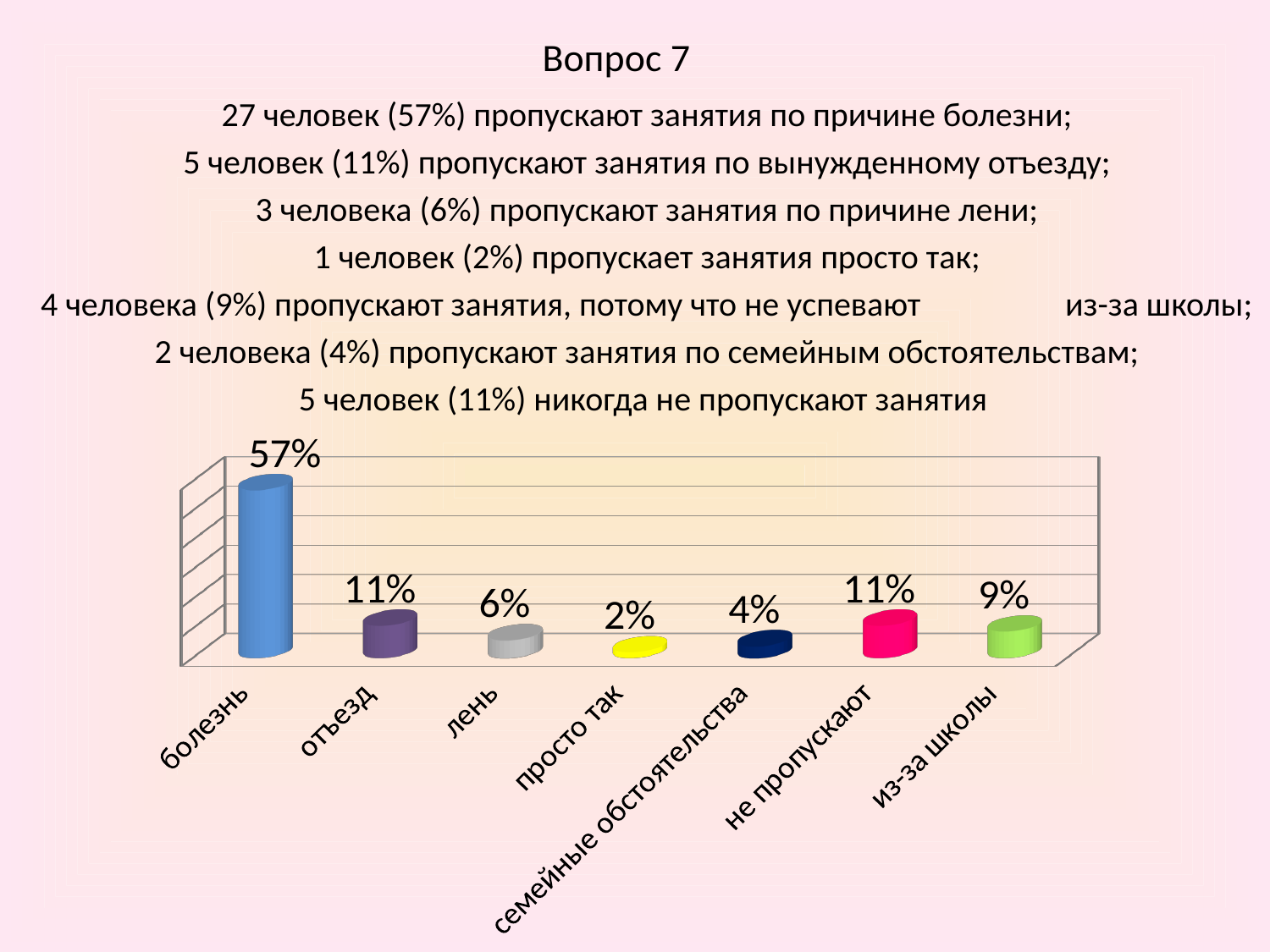
What is the difference between the values for болезнь and отъезд? 46% What is the value for болезнь? 57% How many categories are shown in the chart? 7 What is the value for семейные обстоятельства? 4% What is the value for из-за школы? 9% Which category has the highest value? болезнь What is the difference between the values for из-за школы and лень? 3% What is the value for просто так? 2% Which category has the lowest value? просто так What is the value for отъезд? 11% What kind of chart is shown on the slide? bar chart Which is larger, the value for лень or the value for семейные обстоятельства? лень